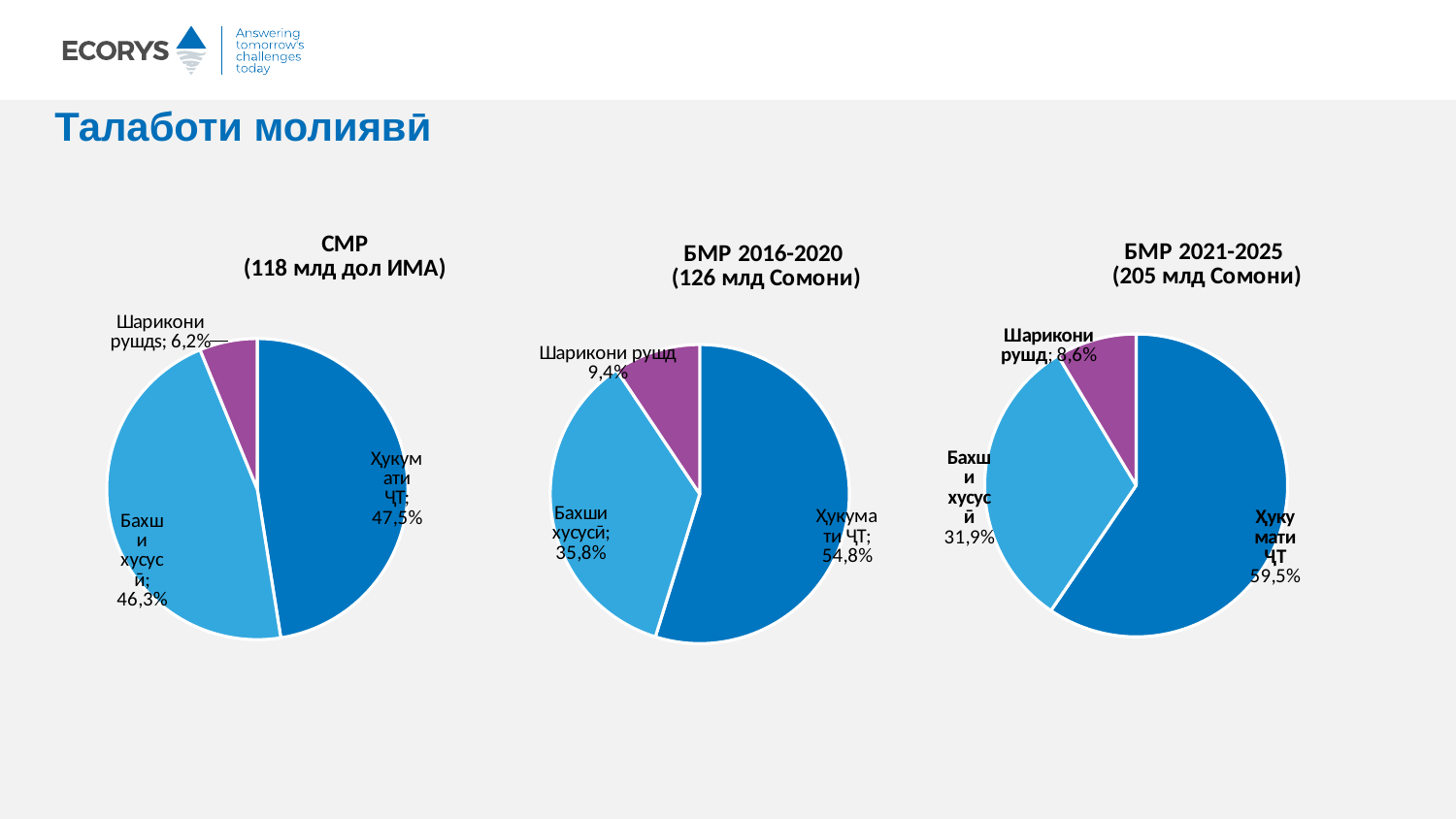
In the 'БМР 2016-2020 (126 млд Сомони)' pie chart, what is the difference between the shares of Ҳукумати ҶТ and Бахши хусусӣ? 19,0 percentage points What type of chart is used for 'БМР 2021-2025 (205 млд Сомони)'? Pie chart In the 'БМР 2016-2020 (126 млд Сомони)' pie chart, what share is shown for Бахши хусусӣ? 35,8% In the 'БМР 2021-2025 (205 млд Сомони)' pie chart, which is larger: the share of Бахши хусусӣ or the share of Шарикони рушд? Бахши хусусӣ How many charts are shown on the slide? 3 In the 'СМР (118 млд дол ИМА)' pie chart, what share is shown for Ҳукумати ҶТ? 47,5% In the 'СМР (118 млд дол ИМА)' pie chart, what share is shown for Шарикони рушд? 6,2% In the 'БМР 2021-2025 (205 млд Сомони)' pie chart, what share is shown for Ҳукумати ҶТ? 59,5% How many slices does the 'СМР (118 млд дол ИМА)' pie chart have? 3 In the 'БМР 2021-2025 (205 млд Сомони)' pie chart, which category has the smallest slice? Шарикони рушд In the 'БМР 2016-2020 (126 млд Сомони)' pie chart, which category has the largest slice? Ҳукумати ҶТ What is the title of the slide? Талаботи молиявӣ